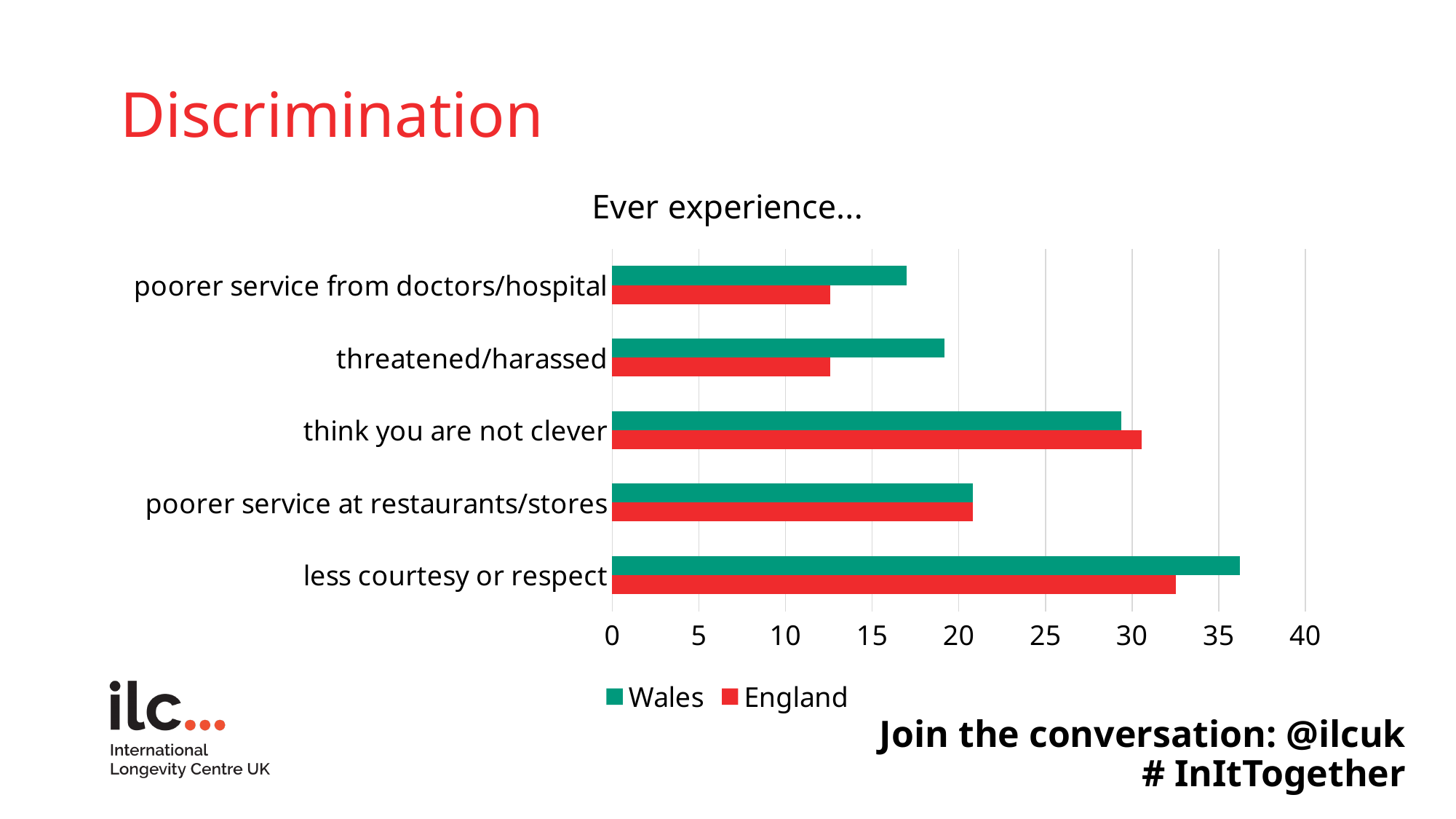
How many series does the legend list? 2 How many categories are shown on the chart? 5 Which series is shown in red? England Which category has the highest value for Wales? less courtesy or respect Is the value for England for 'threatened/harassed' greater or less than 15? less Which category has the lowest value for Wales? poorer service from doctors/hospital What kind of chart is shown on the slide? bar chart Which category has the highest value for England? less courtesy or respect For 'threatened/harassed', which is larger, Wales or England? Wales What is the title of the chart? Ever experience... For 'less courtesy or respect', which is larger, Wales or England? Wales Is the value for Wales for 'less courtesy or respect' greater or less than 35? greater